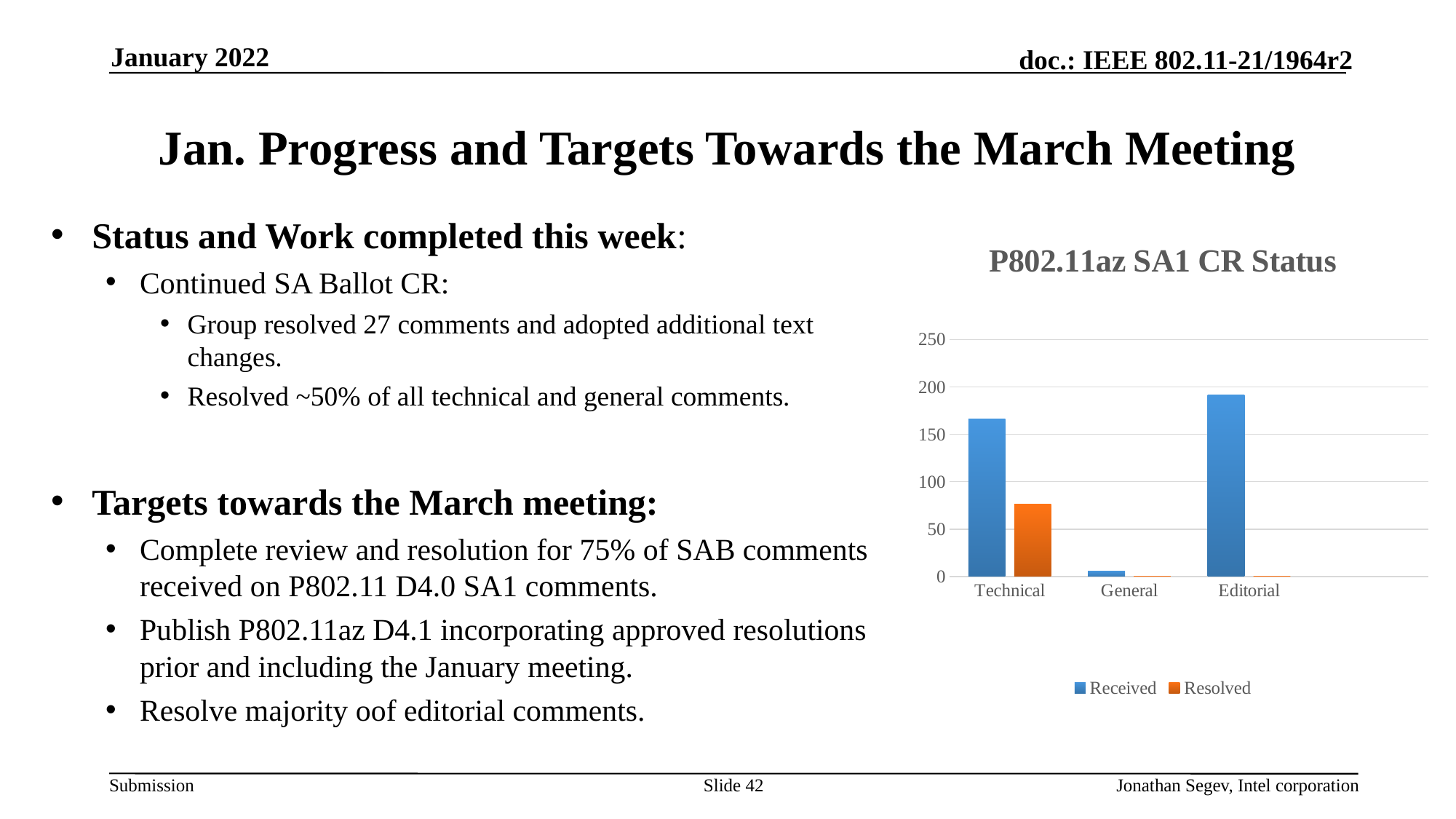
Which category has the lowest Received value? General Is the Received value for Technical greater or less than 150? greater Which series is shown in orange in the chart? Resolved What kind of chart is shown on the slide? bar chart What is the title of the chart on the slide? P802.11az SA1 CR Status Is the Received value for Editorial greater or less than 200? less How many series does the chart legend list? 2 Is the Received value for General greater or less than 50? less How many categories are shown on the x axis of the chart? 3 Which is larger, the Received value for Editorial or the Received value for Technical? Editorial Which category has the highest Received value? Editorial